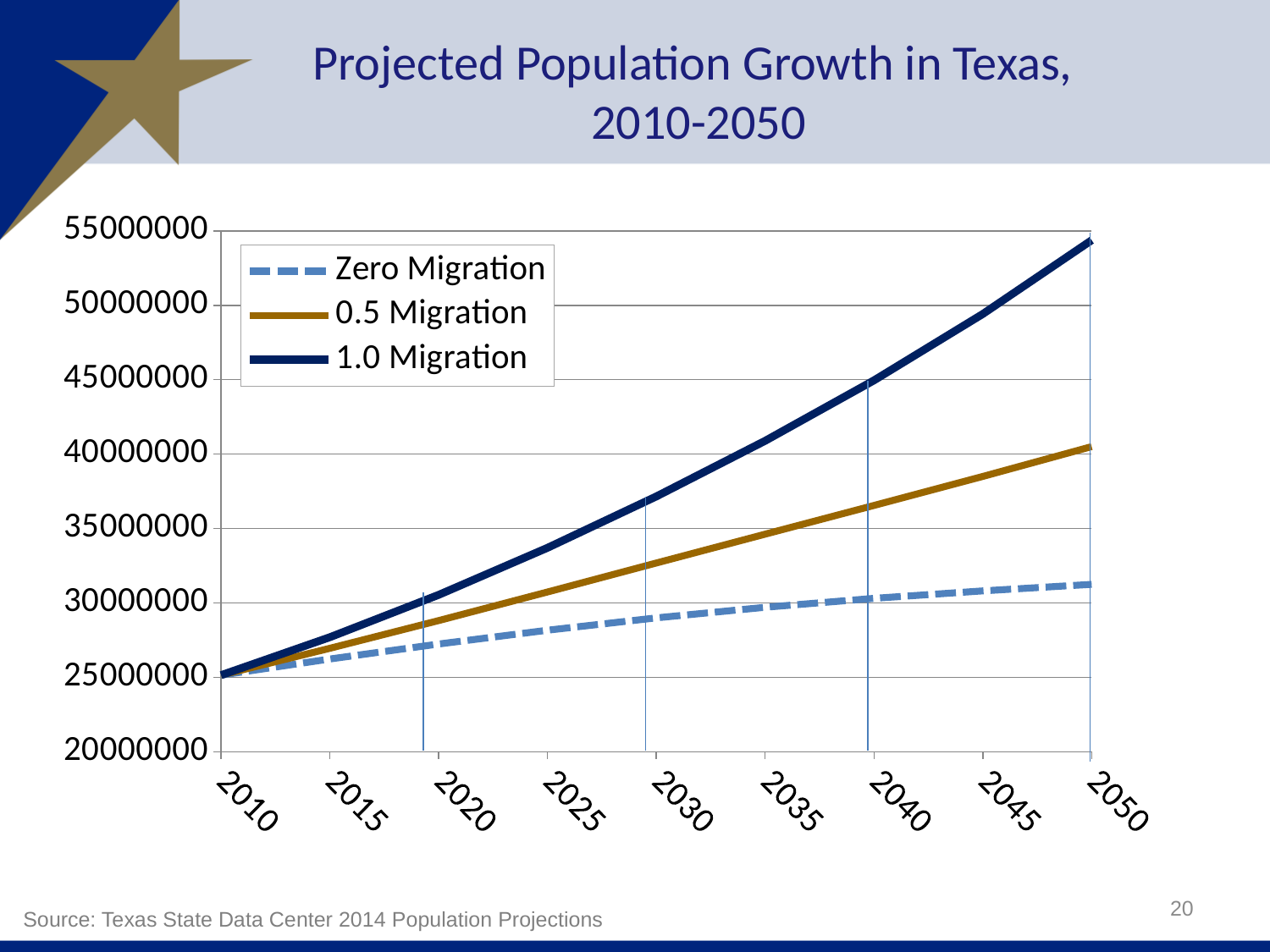
Is the value for 1.0 Migration in 2050 greater or less than 50000000? greater Do the values for the 1.0 Migration series rise or fall from 2010 to 2050? Rise Which series has the lowest value in 2050? Zero Migration Is the value for 1.0 Migration in 2030 greater or less than 35000000? greater Is the value for Zero Migration in 2030 greater or less than 30000000? less What kind of chart is shown on the slide? Line chart What is the title of the chart? Projected Population Growth in Texas, 2010-2050 Which series is drawn with a dashed line? Zero Migration In 2050, which is larger: the 1.0 Migration value or the 0.5 Migration value? 1.0 Migration Which series has the highest value in 2050? 1.0 Migration How many series does the legend list? 3 How many year labels are shown along the x axis? 9